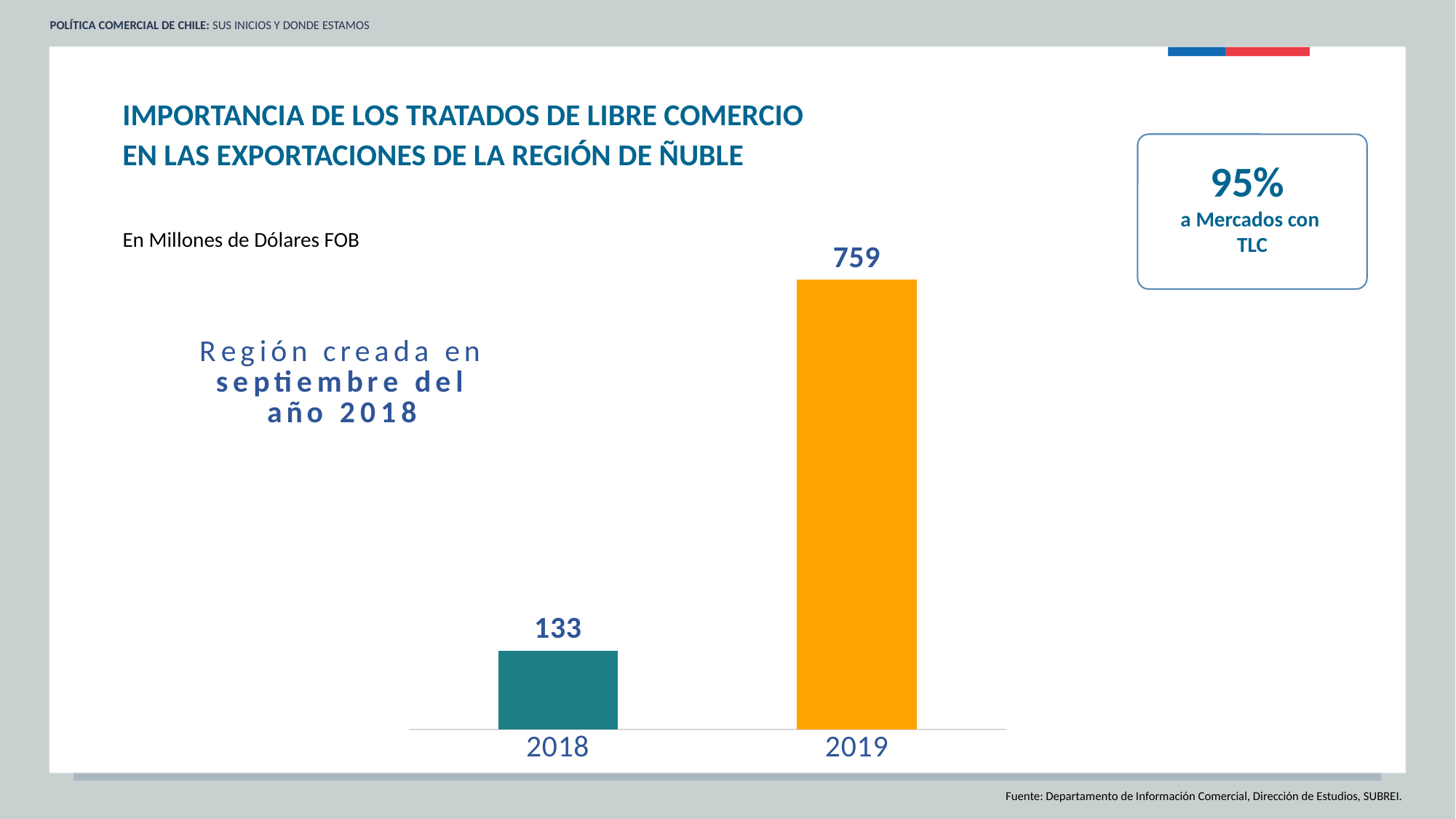
Which year has the lowest value? 2018 Do the values rise or fall from 2018 to 2019? Rise How many bars are shown in the chart? 2 What is the difference between the values for 2019 and 2018? 626 Which year has the highest value? 2019 What kind of chart is shown on the slide? Bar chart What is the value for 2019? 759 What colour is the bar for 2019? Orange What is the value for 2018? 133 What unit are the chart values expressed in? Millones de Dólares FOB Which is larger, the value for 2018 or the value for 2019? 2019